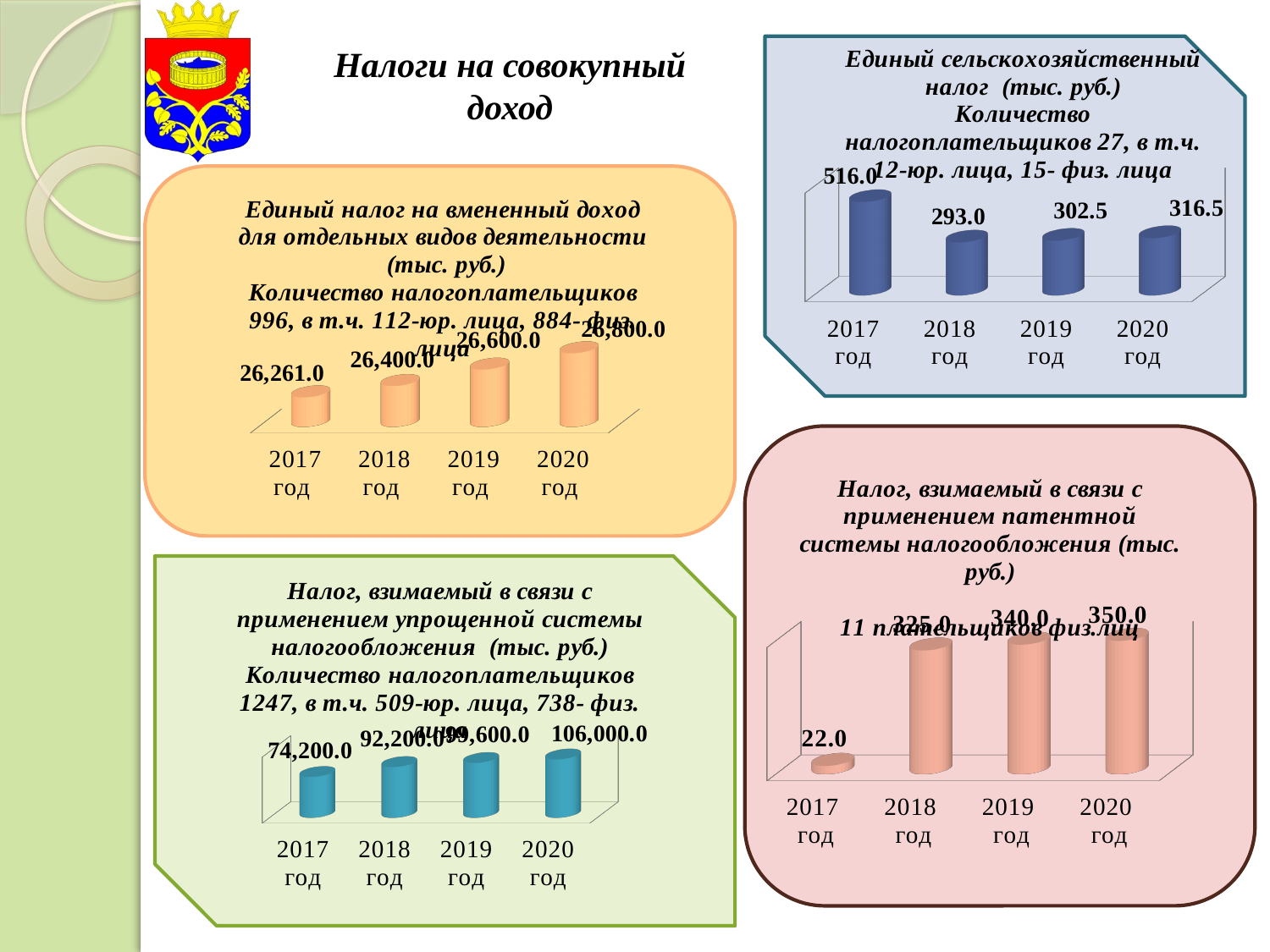
In the bottom-left chart (упрощенная система налогообложения), which year has the highest value? 2020 год How many years are shown on the x axis of the bottom-right chart (патентная система налогообложения)? 4 In the top-left chart (Единый налог на вмененный доход), do the values rise or fall from 2017 to 2020? rise In the top-right chart (Единый сельскохозяйственный налог), which year has the lowest value? 2018 год In the bottom-left chart (упрощенная система налогообложения), what is the value for 2020 год? 106,000.0 What kind of chart is the top-right chart (Единый сельскохозяйственный налог)? bar chart In the top-left chart (Единый налог на вмененный доход), what is the value for 2017 год? 26,261.0 In the bottom-right chart (патентная система налогообложения), which is larger, the value for 2019 or 2020? 2020 In the top-right chart (Единый сельскохозяйственный налог), what is the difference between the 2017 and 2018 values? 223.0 In the top-right chart (Единый сельскохозяйственный налог), what is the value for 2017 год? 516.0 In the bottom-left chart (упрощенная система налогообложения), what is the difference between the 2018 and 2017 values? 18,000.0 In the bottom-right chart (патентная система налогообложения), what is the value for 2017 год? 22.0